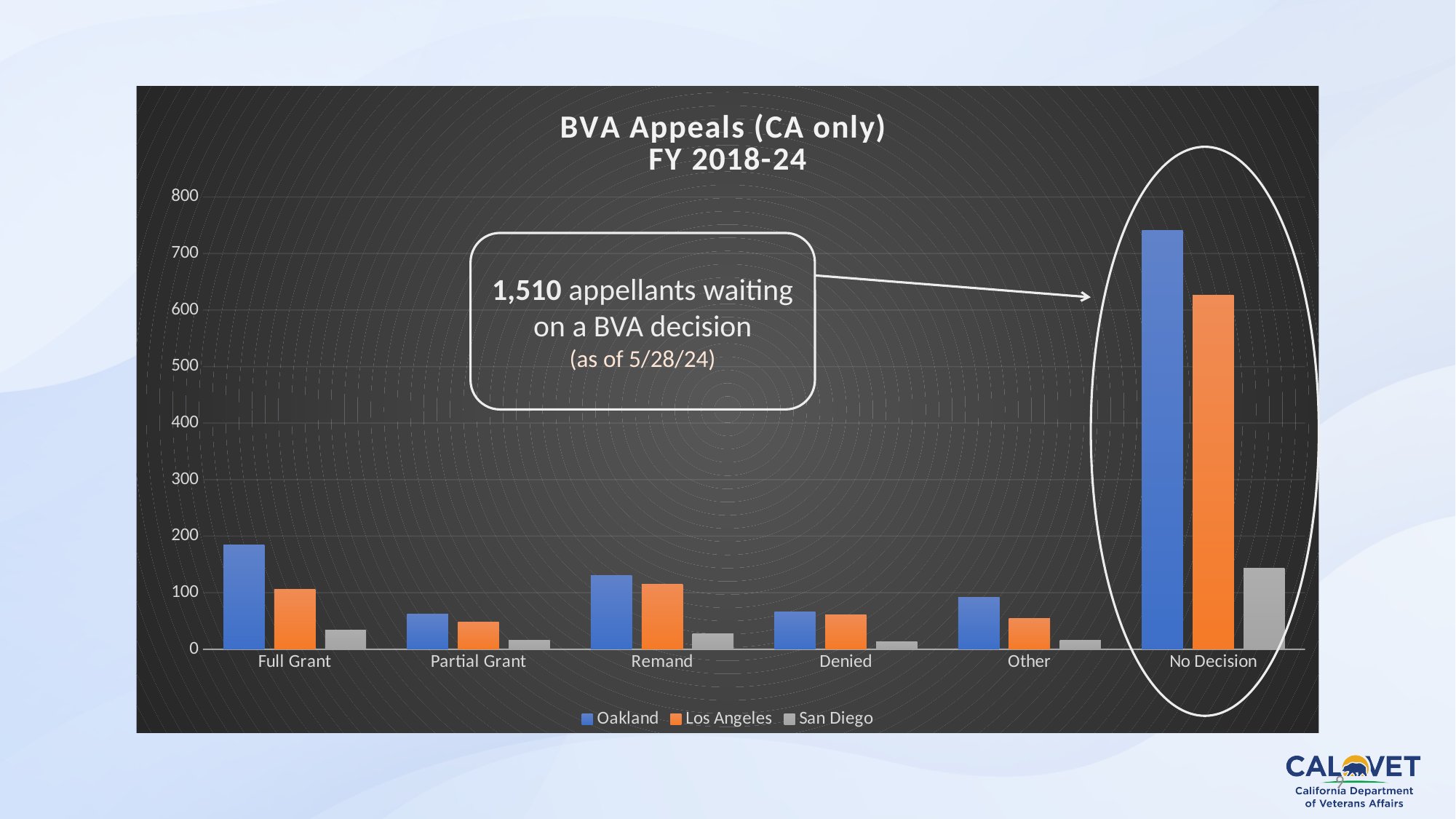
Is the San Diego value for No Decision greater or less than 200? less How many categories are shown on the x axis? 6 How many series does the legend list? 3 Which category has the highest Los Angeles value? No Decision Is the Oakland value for Full Grant greater or less than 200? less What is the title of the chart? BVA Appeals (CA only) FY 2018-24 Is the Los Angeles value for No Decision greater or less than 600? greater Which series has the lowest value in the No Decision category? San Diego Which is larger for Full Grant, the Oakland value or the Los Angeles value? Oakland What kind of chart is shown on the slide? bar chart Which category has the highest Oakland value? No Decision